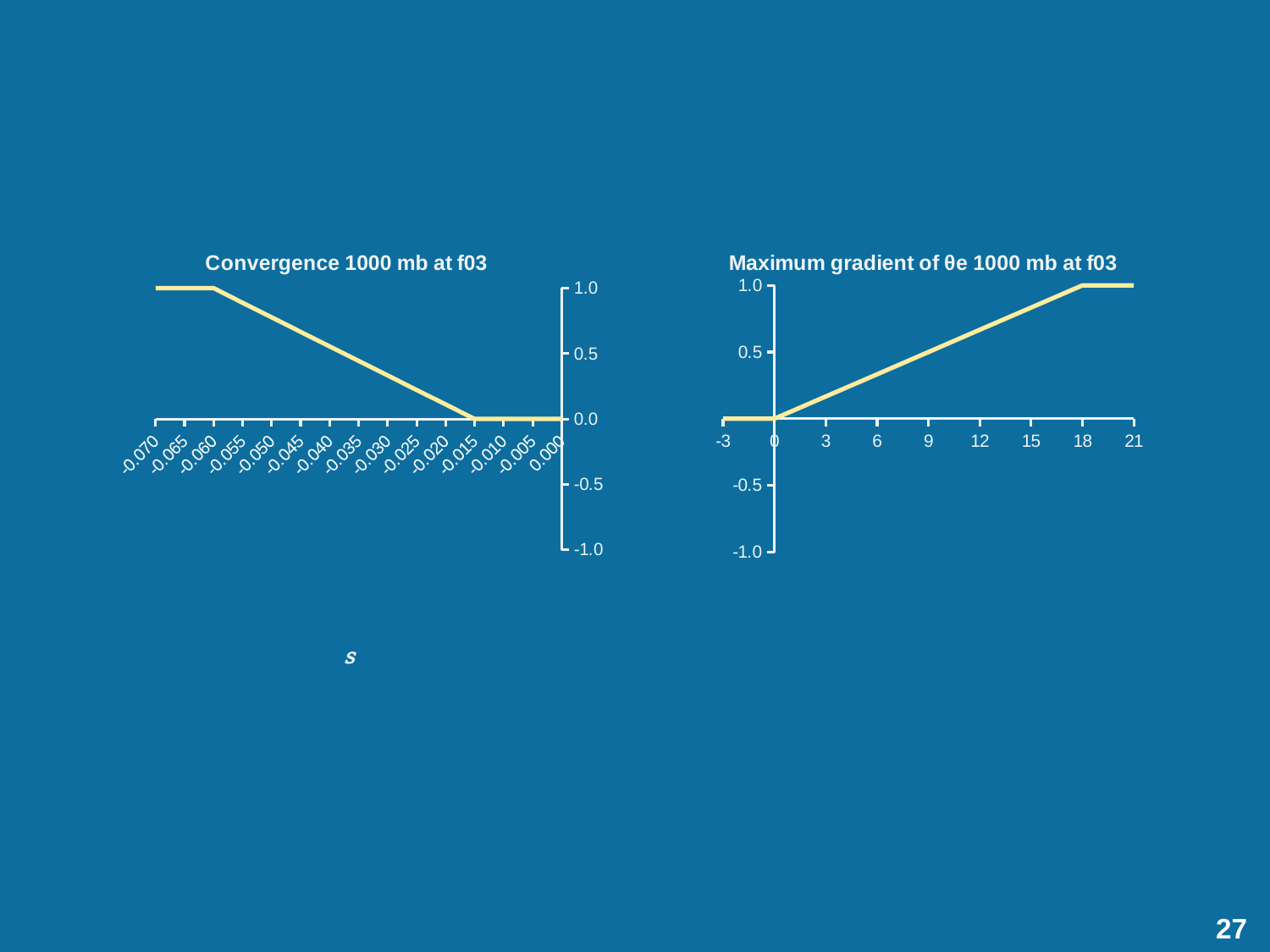
In the 'Maximum gradient of θe 1000 mb at f03' chart, what is the value at 18? 1.0 In the 'Convergence 1000 mb at f03' chart, what is the value at 0.000? 0.0 In the 'Convergence 1000 mb at f03' chart, which is larger, the value at -0.065 or the value at -0.020? -0.065 In the 'Maximum gradient of θe 1000 mb at f03' chart, what is the value at 0? 0.0 In the 'Maximum gradient of θe 1000 mb at f03' chart, which is larger, the value at 6 or the value at 15? 15 In the 'Convergence 1000 mb at f03' chart, what is the value at -0.070? 1.0 In the 'Convergence 1000 mb at f03' chart, do the values rise or fall as the x axis goes from -0.060 to -0.015? fall What type of chart is the 'Convergence 1000 mb at f03' chart? line chart In the 'Convergence 1000 mb at f03' chart, is the value at -0.050 greater or less than 0.5? greater In the 'Maximum gradient of θe 1000 mb at f03' chart, is the value at 12 greater or less than 0.5? greater How many x-axis labels does the 'Convergence 1000 mb at f03' chart show? 15 In the 'Maximum gradient of θe 1000 mb at f03' chart, do the values rise or fall as the x axis goes from 0 to 18? rise